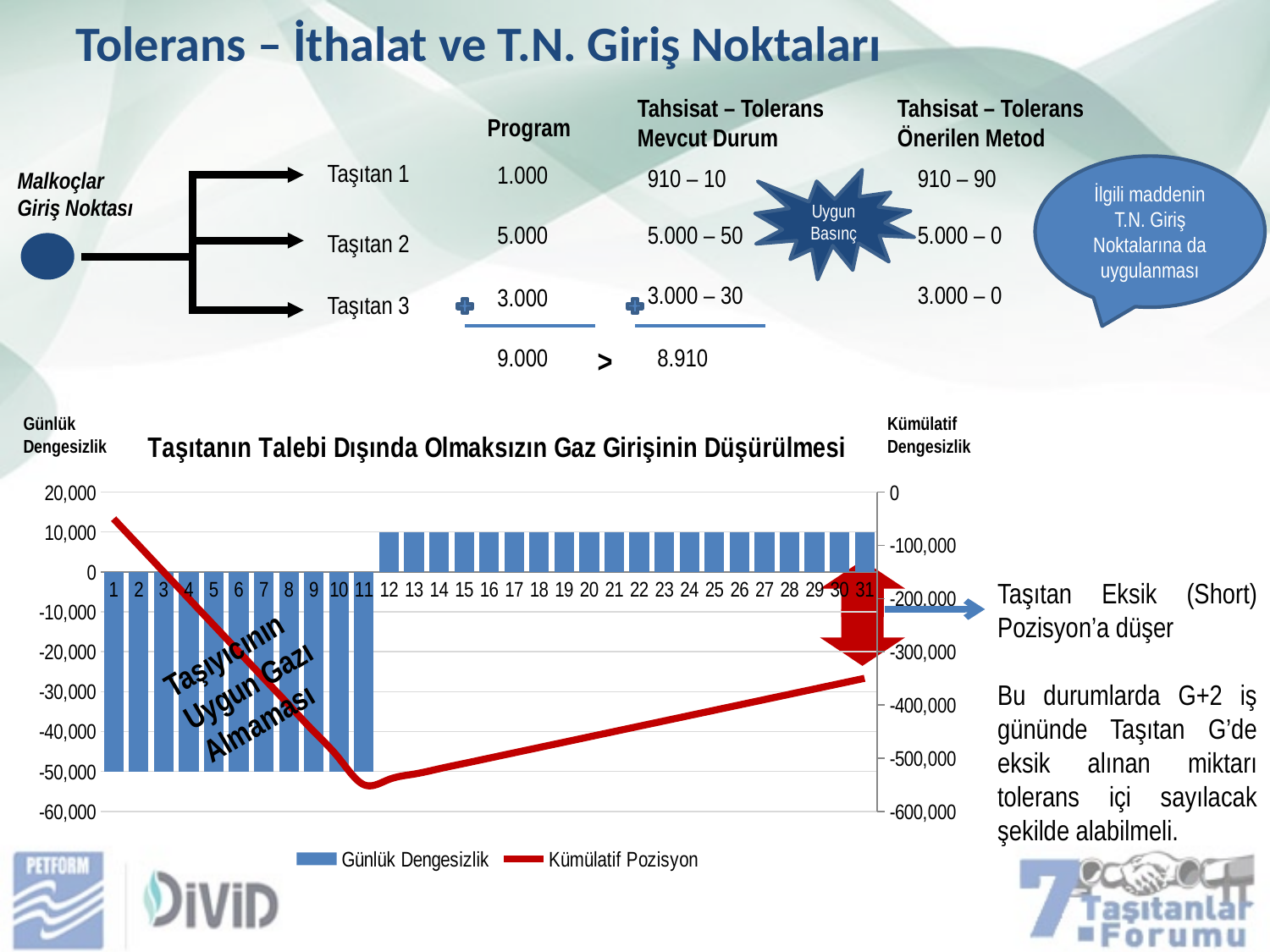
How many series does the chart legend list? 2 Is the Kümülatif Pozisyon value at day 1 greater or less than -100,000 on the right axis? greater How many days (categories) are plotted along the x axis of the chart? 31 Is the Günlük Dengesizlik value for day 20 greater or less than 0? greater What are the two entries in the chart legend? Günlük Dengesizlik and Kümülatif Pozisyon Is the Günlük Dengesizlik value for day 5 greater or less than -40,000? less Does the Kümülatif Pozisyon line rise or fall from day 1 to day 11? fall What kind of chart is shown on the slide? bar and line chart Does the Kümülatif Pozisyon line rise or fall from day 12 to day 31? rise Which has the larger Günlük Dengesizlik value, day 3 or day 15? day 15 What is the title of the chart? Taşıtanın Talebi Dışında Olmaksızın Gaz Girişinin Düşürülmesi